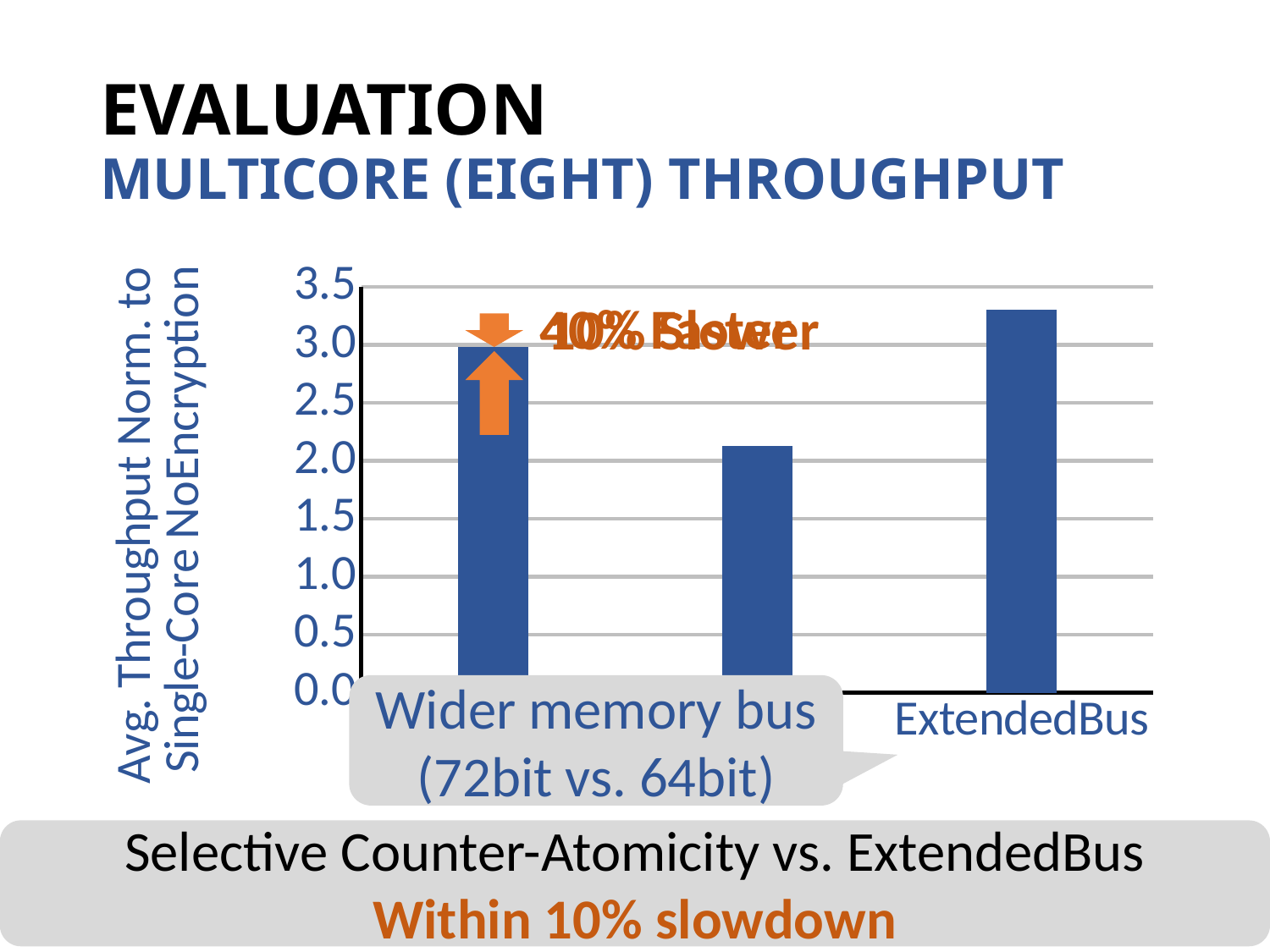
Is the value for ExtendedBus greater or less than 3.5? less What is the y-axis label of the chart? Avg. Throughput Norm. to Single-Core NoEncryption Which bar is the tallest in the chart? ExtendedBus Is the middle bar greater or less than 2.5? less Is the middle bar greater or less than 2.0? greater What kind of chart is shown on the slide? bar chart What is the highest value shown on the y axis? 3.5 Which is larger, the leftmost bar or the middle bar? the leftmost bar Which is larger, the leftmost bar or the ExtendedBus bar? ExtendedBus How many bars are plotted in the chart? 3